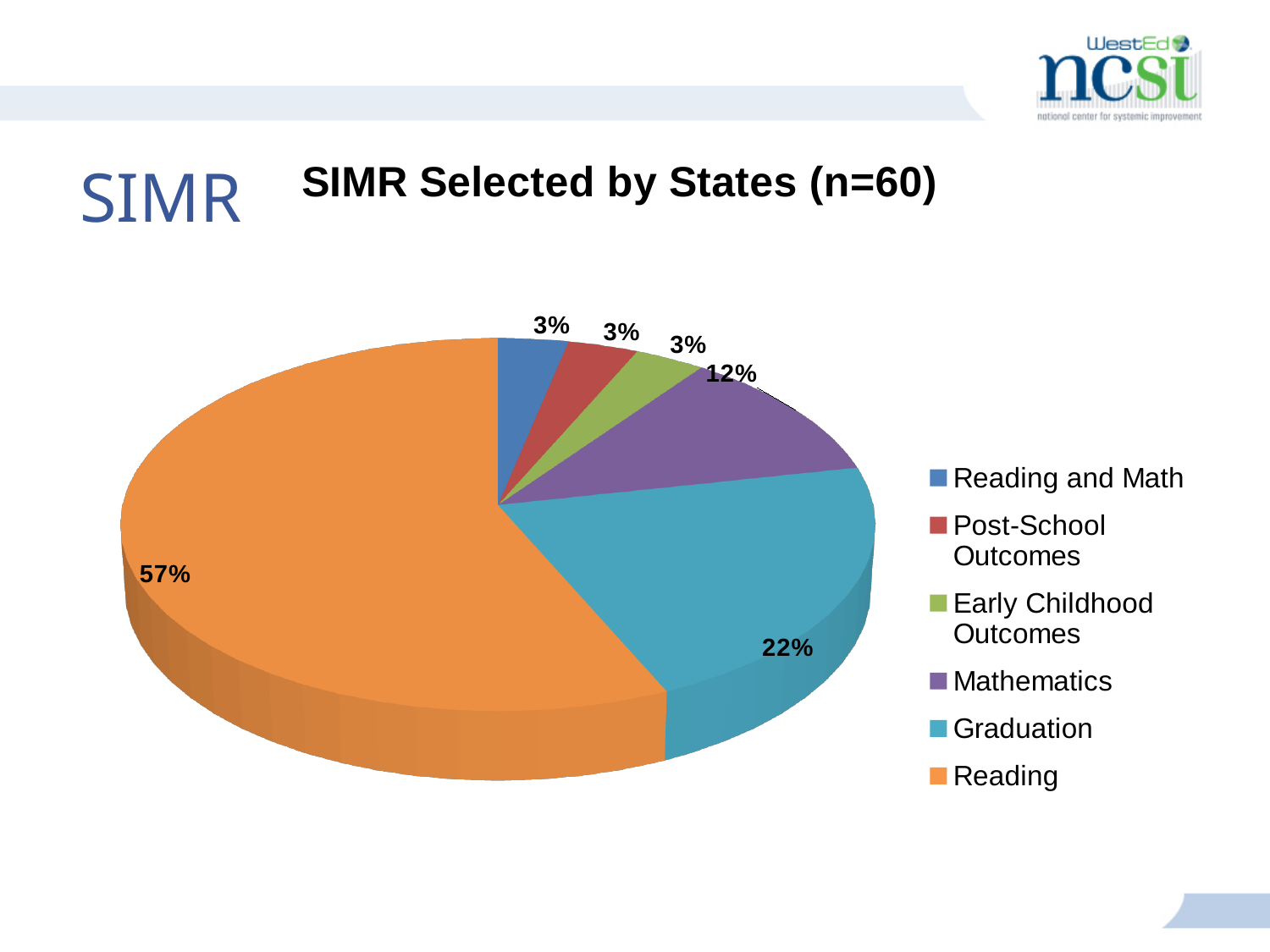
What is the title of the chart? SIMR Selected by States (n=60) What kind of chart is shown on the slide? pie chart What share of the pie does Mathematics represent? 12% What is the combined share of Reading and Graduation? 79% Which is larger, the share for Graduation or the share for Mathematics? Graduation What share of the pie does Reading represent? 57% How many categories does the legend list? 6 What share of the pie does Graduation represent? 22% Which colour represents Mathematics in the chart? purple What is the difference between the Reading share and the Graduation share? 35% Which category has the largest slice of the pie? Reading